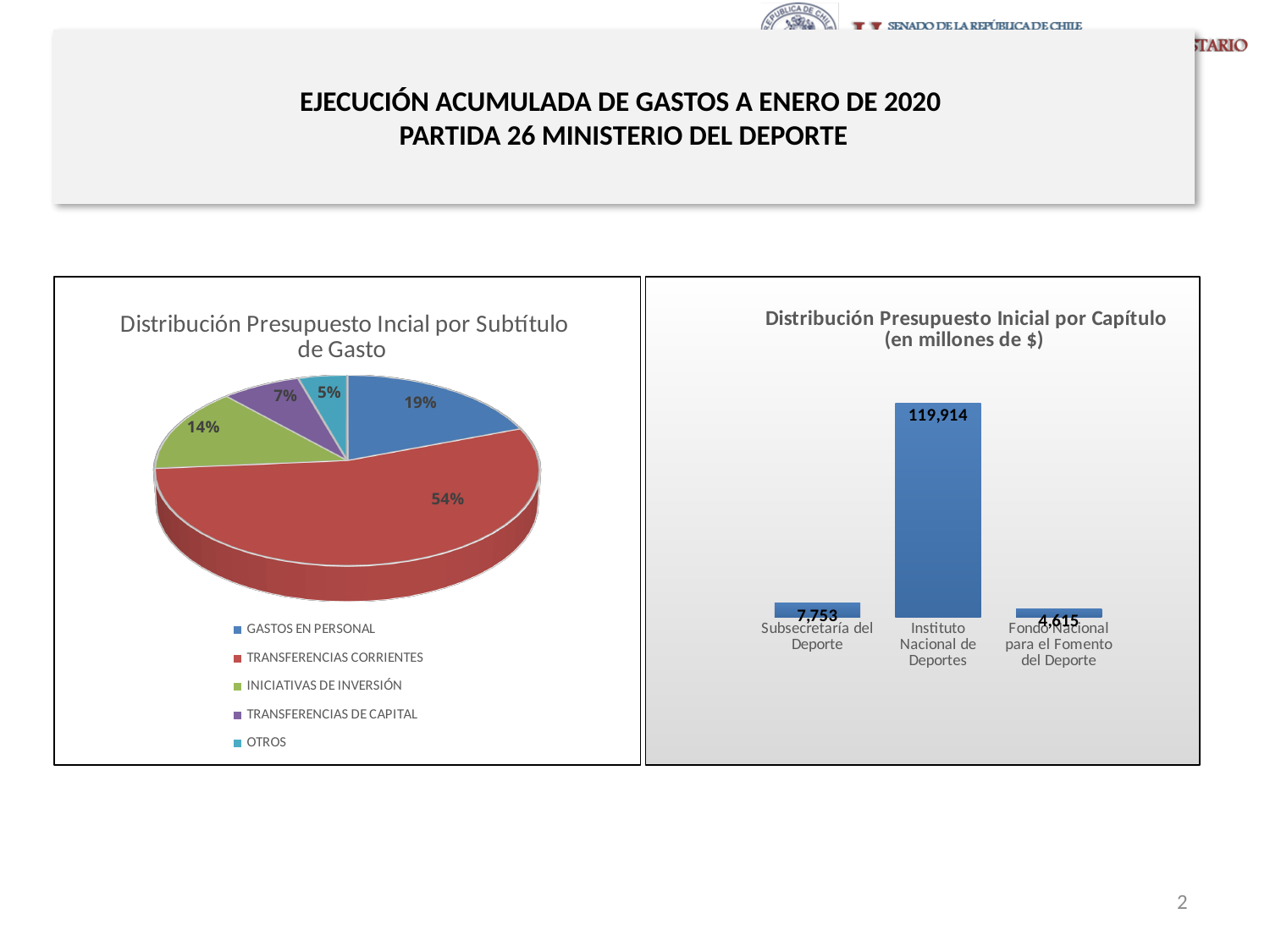
In the chart on the right, which category has the lowest value? Fondo Nacional para el Fomento del Deporte What kind of chart is the chart on the right? Bar chart In the pie chart on the left, how many categories does the legend list? 5 In the chart on the right, what is the difference between Subsecretaría del Deporte and Fondo Nacional para el Fomento del Deporte? 3,138 In the pie chart on the left, which category has the smallest share? OTROS In the pie chart on the left, which category has the largest share? TRANSFERENCIAS CORRIENTES In the chart on the right, what is the value for Instituto Nacional de Deportes? 119,914 In the pie chart on the left, what is the difference in percentage points between TRANSFERENCIAS DE CAPITAL and OTROS? 2 In the chart on the right, what is the value for Subsecretaría del Deporte? 7,753 In the pie chart on the left, what share does TRANSFERENCIAS CORRIENTES have? 54% In the pie chart on the left, what share does INICIATIVAS DE INVERSIÓN have? 14% In the pie chart on the left, what share does GASTOS EN PERSONAL have? 19%